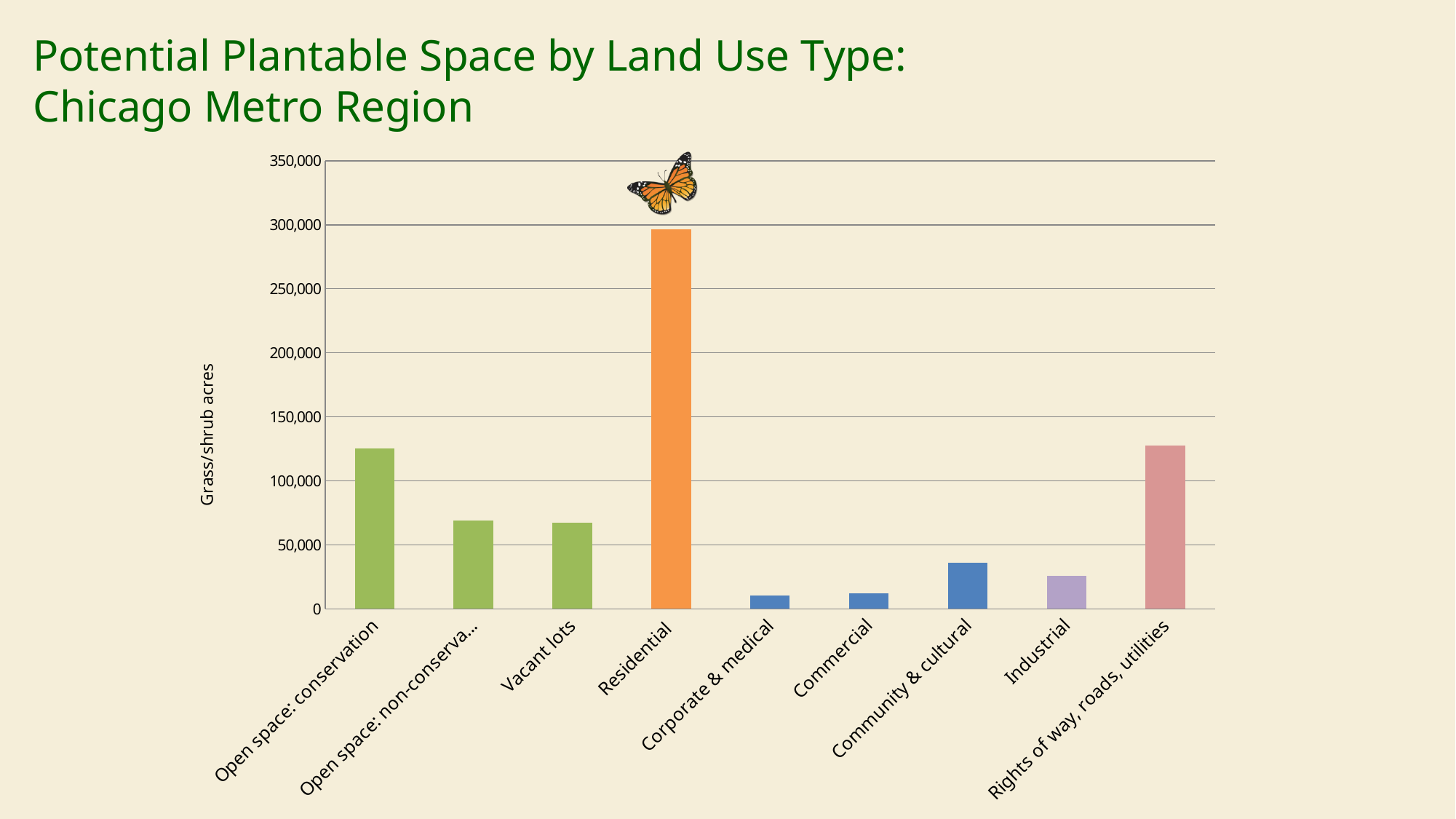
Is the value for Residential greater or less than 250,000? greater What kind of chart is shown on the slide? Bar chart What is the label on the vertical axis of the chart? Grass/shrub acres Which is larger, the value for Community & cultural or the value for Industrial? Community & cultural Is the value for Open space: conservation greater or less than 150,000? less Which land use type has the highest potential plantable space? Residential What colour is the Residential bar? Orange Is the value for Community & cultural greater or less than 50,000? less Which is larger, the value for Residential or the value for Open space: conservation? Residential How many land use categories are plotted on the chart? 9